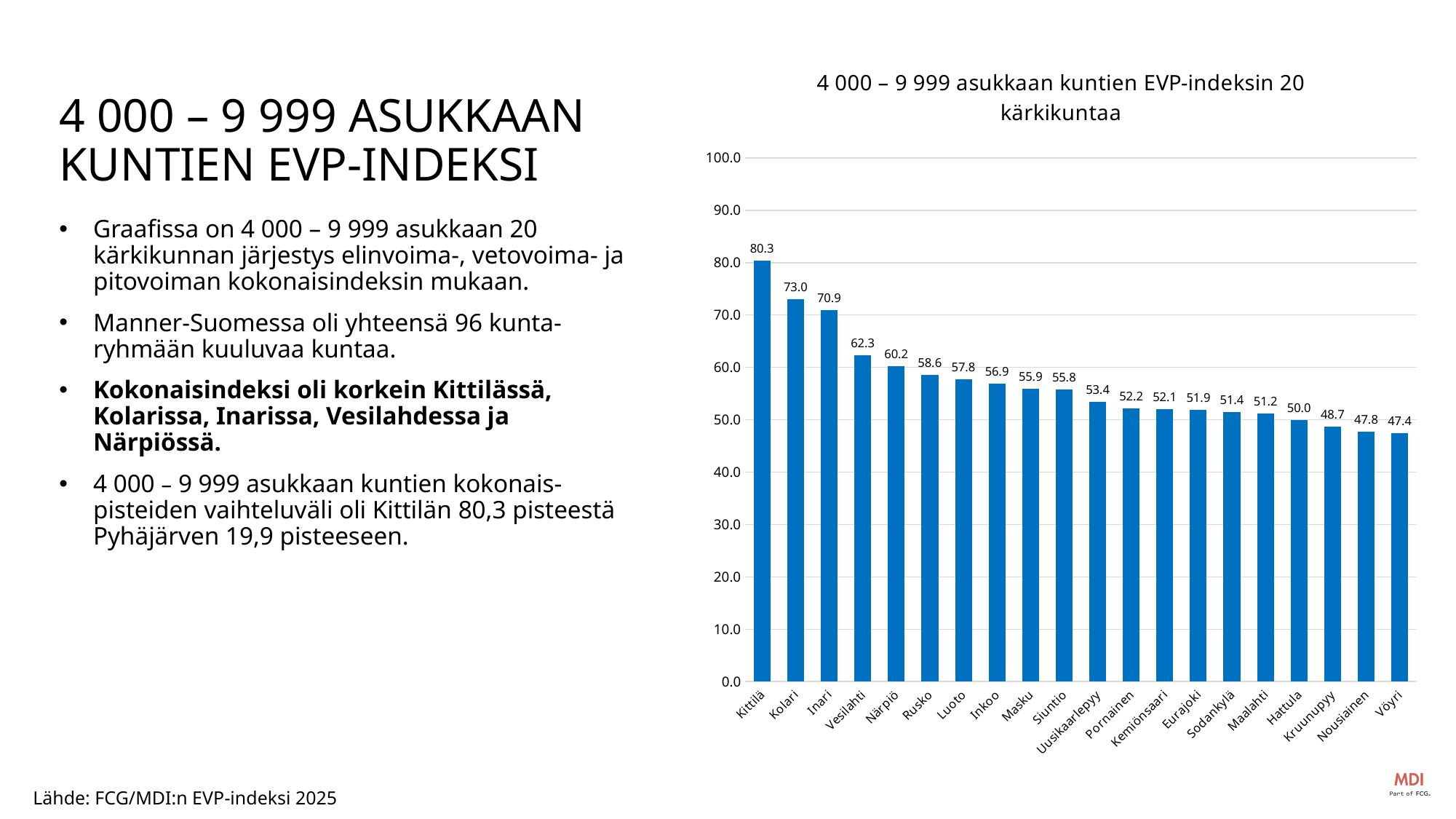
Which municipality has the highest value in the chart? Kittilä Which municipality has the lowest value in the chart? Vöyri What is the EVP index value for Kittilä? 80.3 What is the difference between the values for Kittilä and Kolari? 7.3 What is the value shown for Hattula? 50.0 What is the difference between the values for Inari and Vesilahti? 8.6 Do the values rise or fall from left to right along the x axis? Fall Is the value for Kruunupyy greater or less than 50.0? less Which has a higher value, Rusko or Masku? Rusko How many municipalities are shown in the chart? 20 What kind of chart is shown on the slide? Bar chart What is the value shown for Närpiö? 60.2